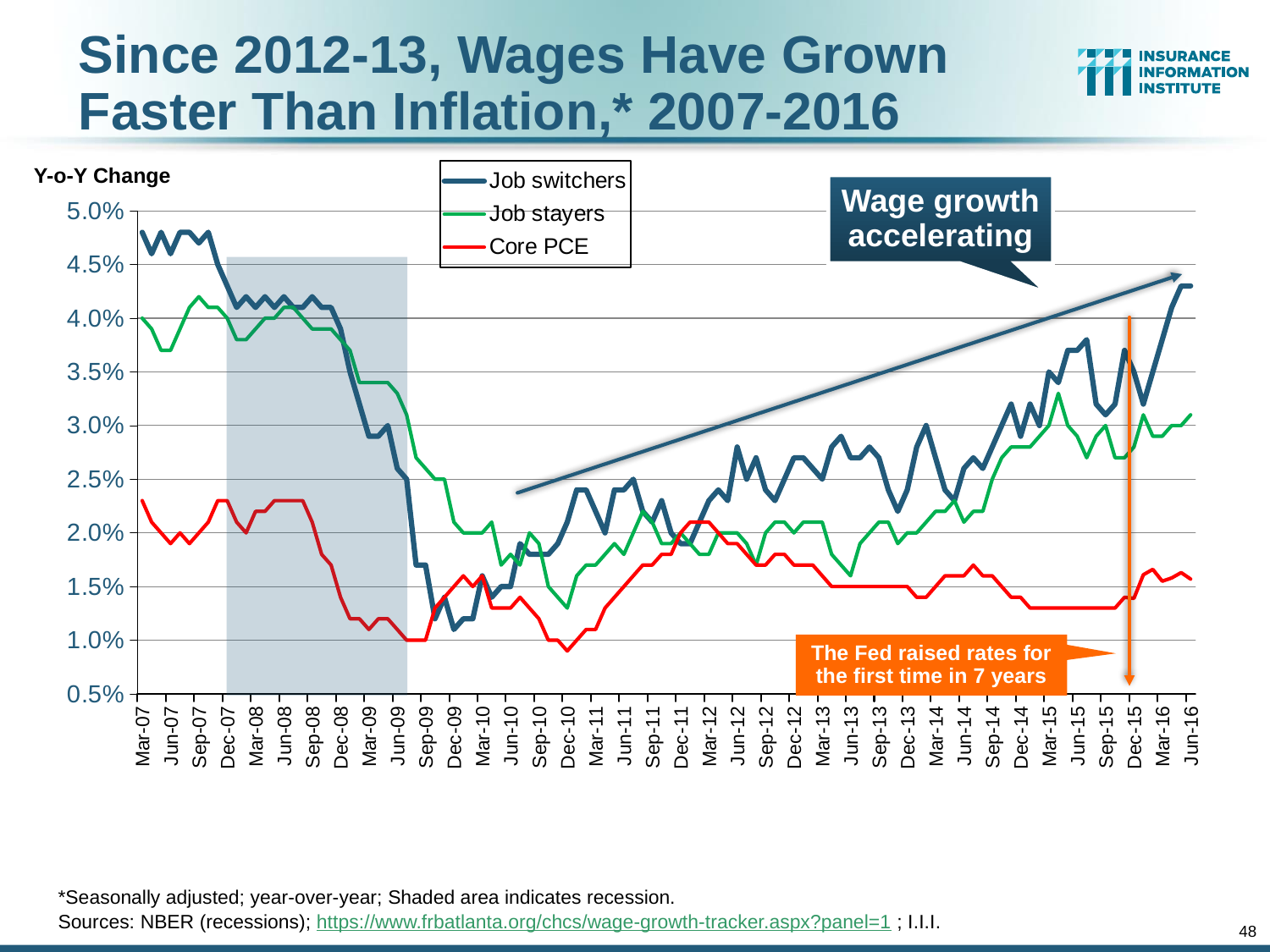
At Mar-07, which is larger: Job switchers or Job stayers? Job switchers Is the value for Core PCE at Jun-16 greater or less than 2.0%? less Is the value for Core PCE at Dec-10 greater or less than 1.0%? less At Jun-16, which is larger: Job switchers or Core PCE? Job switchers What does the shaded area on the chart indicate, according to the footnote? Recession What kind of chart is shown on the slide? Line chart Is the value for Job switchers at Mar-07 greater or less than 4.5%? greater Which series are listed in the legend? Job switchers, Job stayers, Core PCE How many series does the legend list? 3 Does the Job switchers series rise or fall between Dec-07 and Sep-09? Fall